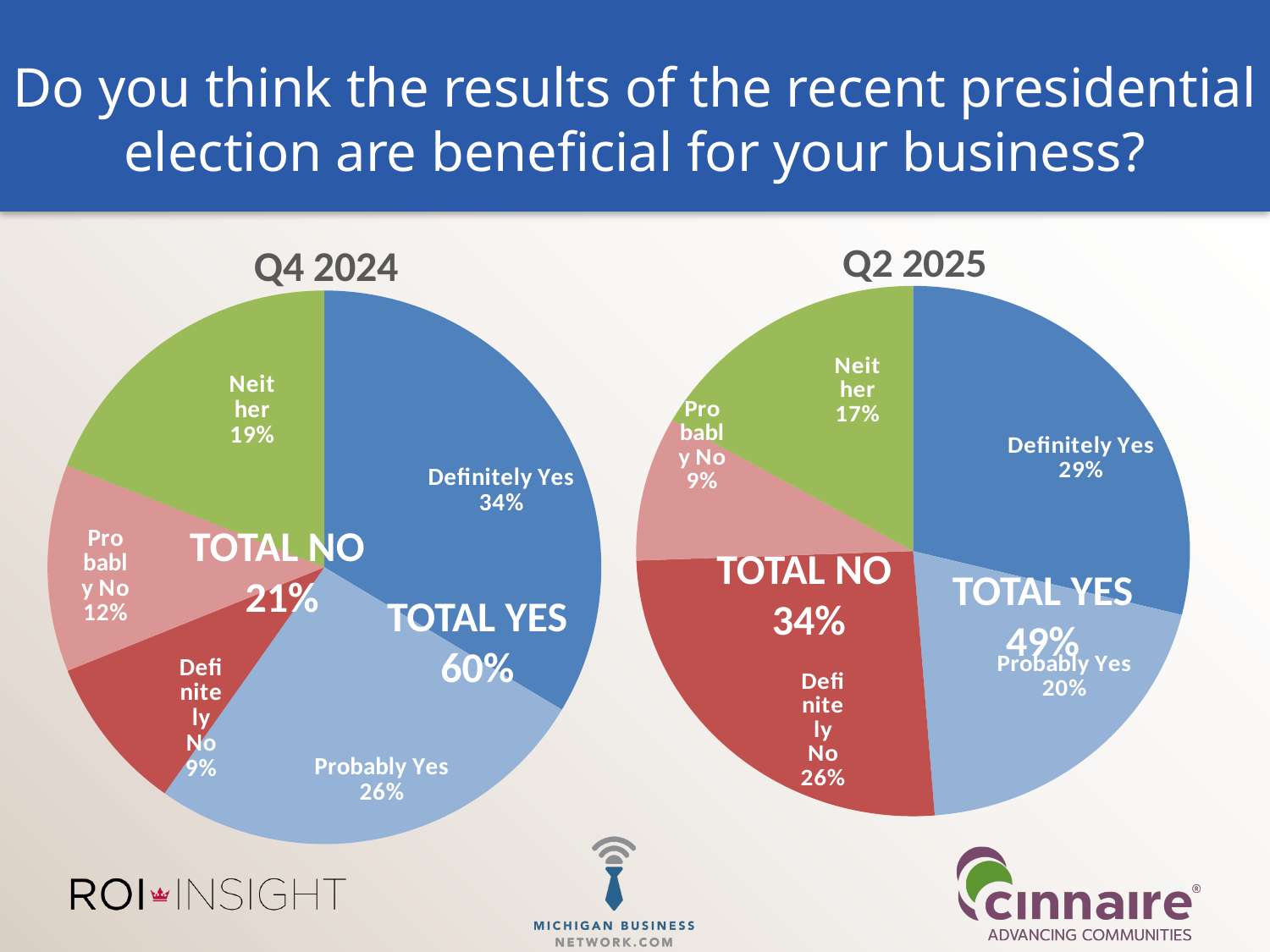
In the Q2 2025 pie chart, which is larger: Definitely No or Probably Yes? Definitely No In the Q4 2024 pie chart, which response has the smallest share? Definitely No What is the TOTAL YES figure shown on the Q2 2025 pie chart? 49% In the Q2 2025 pie chart, what percentage answered Definitely No? 26% In the Q2 2025 pie chart, which response has the smallest share? Probably No In the Q4 2024 pie chart, what percentage answered Definitely Yes? 34% What is the difference between the Definitely Yes share in Q4 2024 and in Q2 2025? 5% What type of chart is used for Q4 2024? Pie chart How many slices does the Q2 2025 pie chart have? 5 In the Q4 2024 pie chart, what percentage answered Neither? 19% In the Q4 2024 pie chart, which response has the largest share? Definitely Yes In the Q2 2025 pie chart, what percentage answered Probably No? 9%